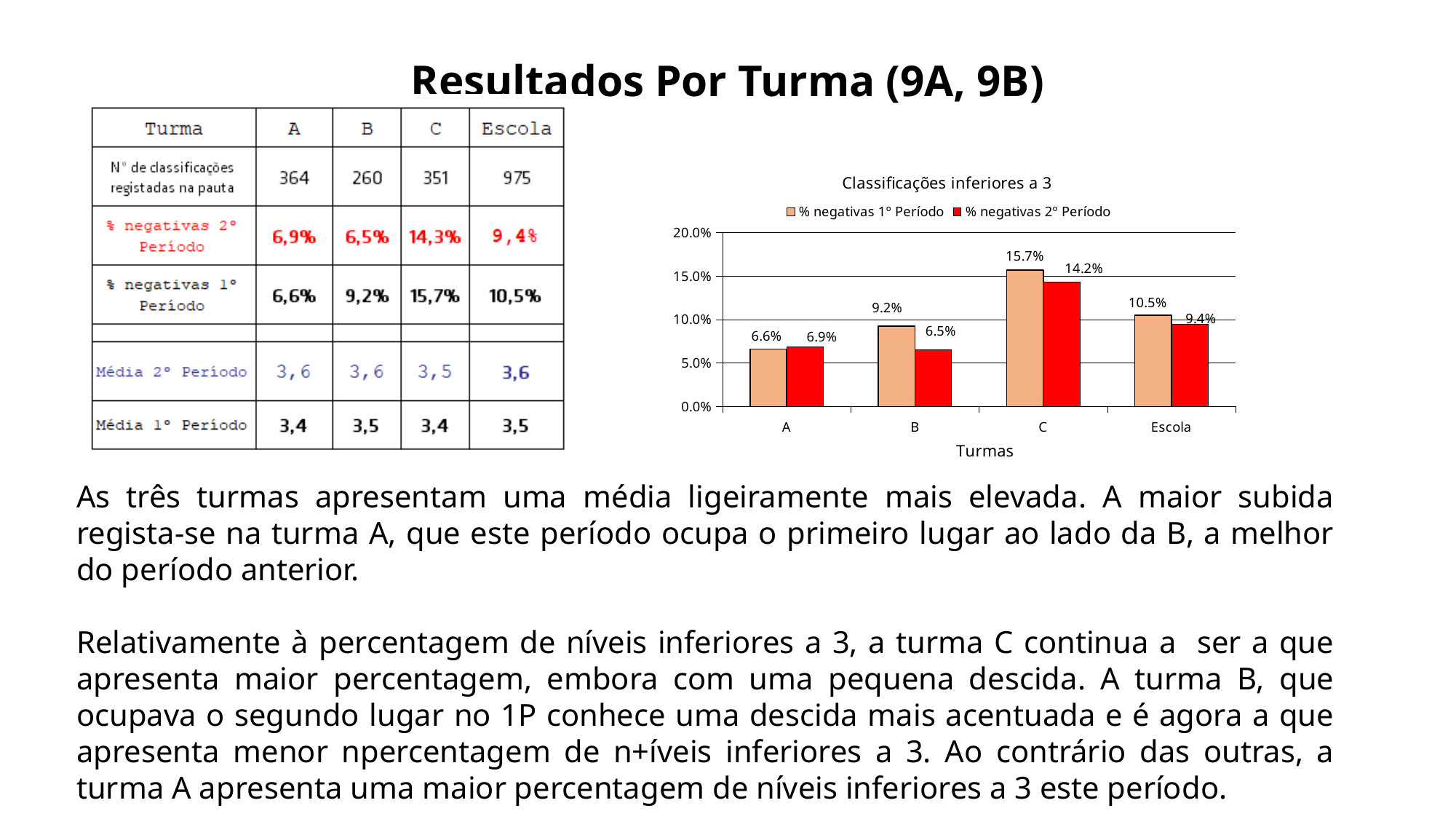
What is the title of the chart? Classificações inferiores a 3 How many categories are shown on the x axis of the chart? 4 What is the value for Escola in the "% negativas 2º Período" series? 9.4% Which category has the lowest value in the "% negativas 1º Período" series? A Is the "% negativas 1º Período" value for Escola greater or less than 10.0%? greater What is the difference between the "% negativas 1º Período" and "% negativas 2º Período" values for turma B? 2.7% For turma A, which is larger: the "% negativas 1º Período" value or the "% negativas 2º Período" value? % negativas 2º Período What kind of chart is shown on the slide? Bar chart How many series does the chart legend list? 2 What is the value for turma C in the "% negativas 1º Período" series? 15.7% What is the value for turma B in the "% negativas 2º Período" series? 6.5% Which category has the highest value in the "% negativas 2º Período" series? C